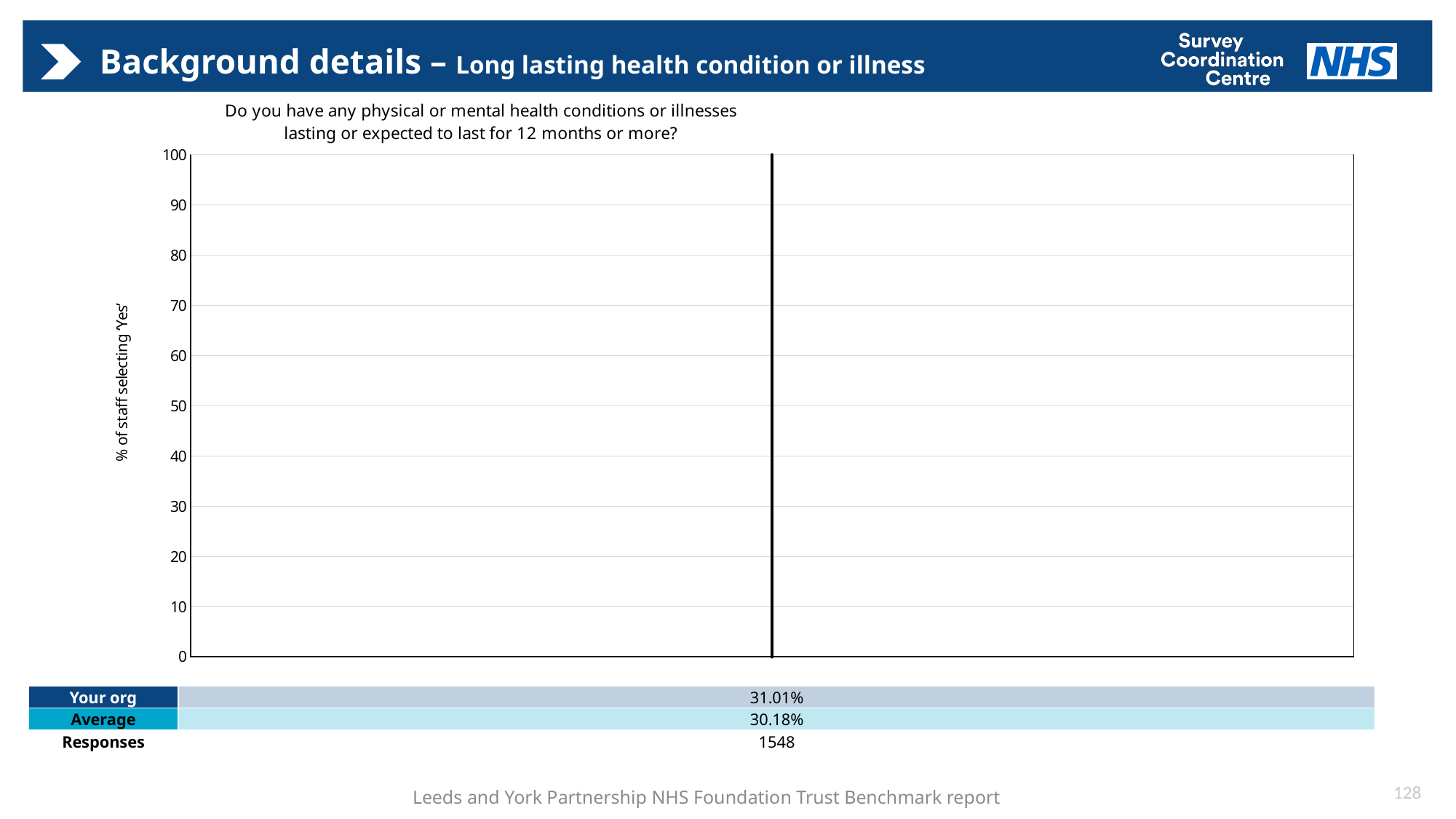
Is the Your org value greater or less than 30? greater Which is larger, the Your org value or the Average value? Your org What is the maximum value shown on the chart's vertical axis? 100 What is the label of the chart's vertical axis? % of staff selecting 'Yes' What is the value for Your org in the table below the chart? 31.01% What is the Average value shown in the table below the chart? 30.18% How many responses are reported below the chart? 1548 Is the Average value greater or less than 40? less What is the difference between the Your org value and the Average value? 0.83%